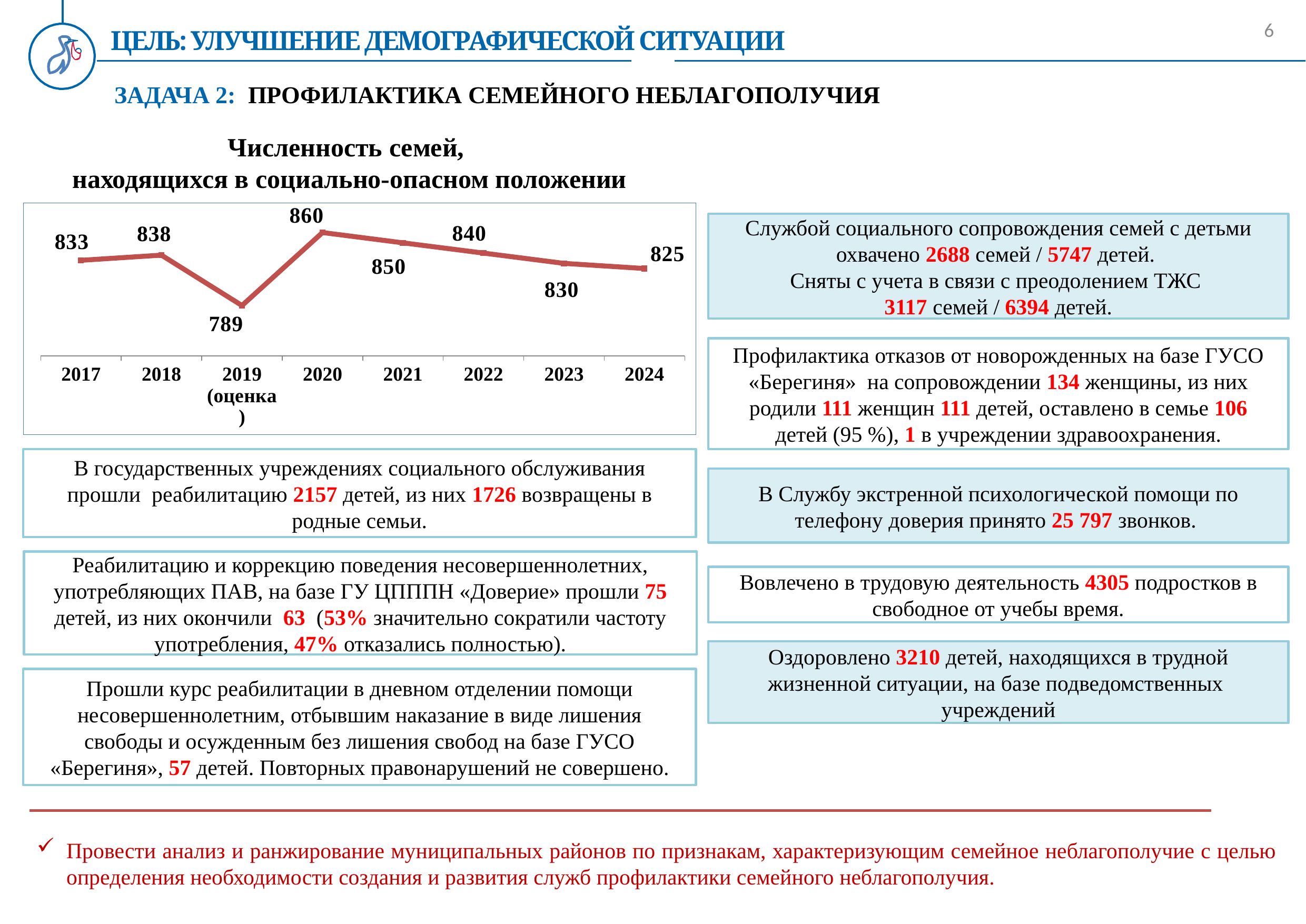
What is the value for 2024 in the chart? 825 What is the difference between the values for 2018 and 2017? 5 How many years are plotted in the chart? 8 Which year has the lowest value in the chart? 2019 Do the values rise or fall from 2020 to 2024? fall What kind of chart is shown on the slide? line chart What is the value for 2017 in the chart 'Численность семей, находящихся в социально-опасном положении'? 833 What is the difference between the values for 2020 and 2019? 71 Which year on the x axis is marked as an estimate (оценка)? 2019 What is the value for 2020 in the chart? 860 Which is larger, the value for 2021 or the value for 2023? 2021 Which year has the highest value in the chart? 2020